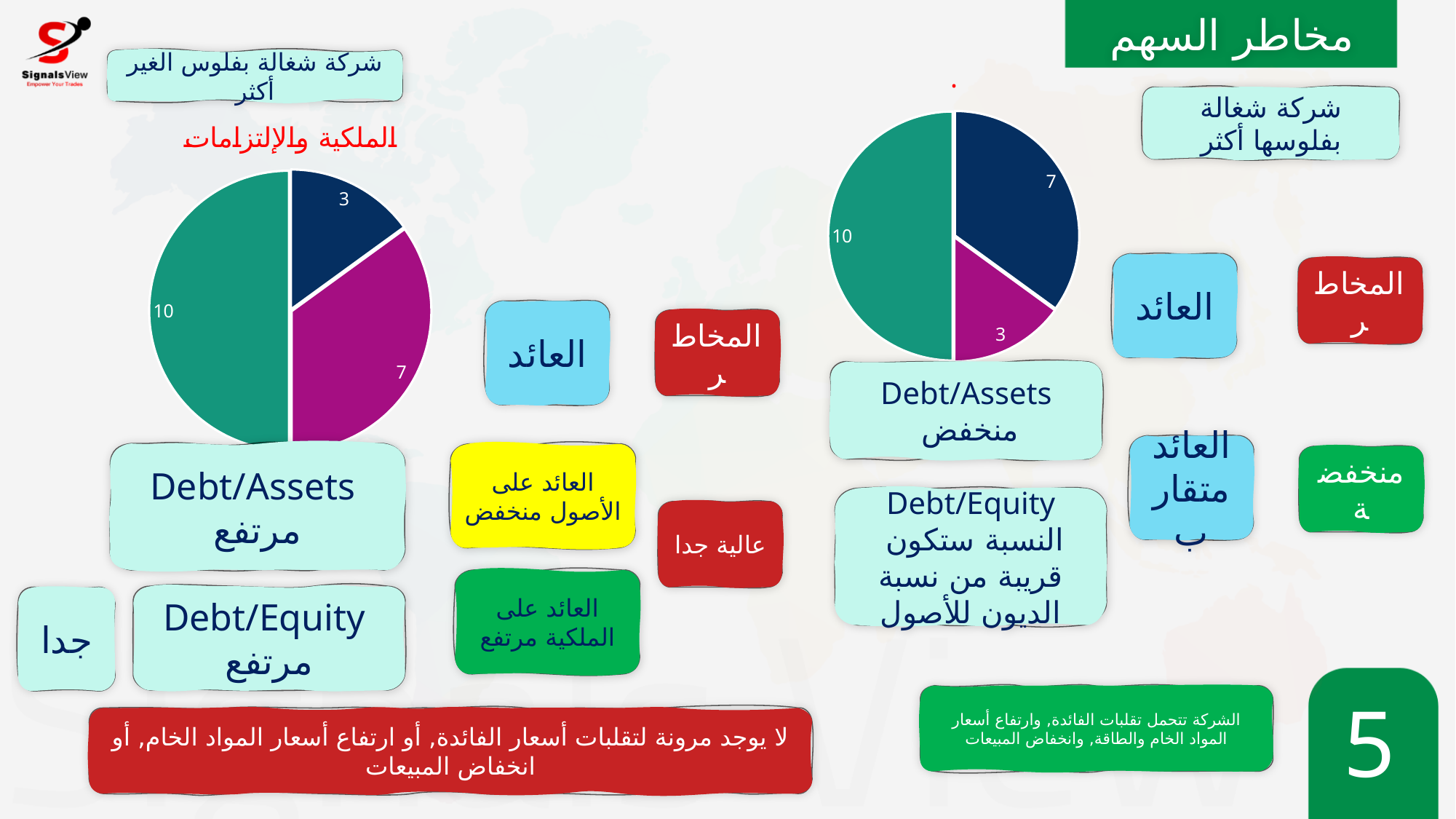
How many slices does the pie chart on the left side of the slide have? 3 What kind of chart is the chart on the left side of the slide? pie chart In the pie chart on the left side of the slide, which colour slice has the largest value? teal In the pie chart on the right side of the slide, what value is shown on the dark blue slice? 7 In the pie chart on the left side of the slide, what is the difference between the teal slice value and the dark blue slice value? 7 In the pie chart on the left side of the slide, what value is shown on the purple slice? 7 In the pie chart on the left side of the slide, what value is shown on the dark blue slice? 3 What kind of chart is the chart on the right side of the slide? pie chart How many slices does the pie chart on the right side of the slide have? 3 In the pie chart on the right side of the slide, what share of the total does the teal slice represent? 50% In the pie chart on the right side of the slide, which colour slice has the smallest value? purple In the pie chart on the right side of the slide, what value is shown on the purple slice? 3